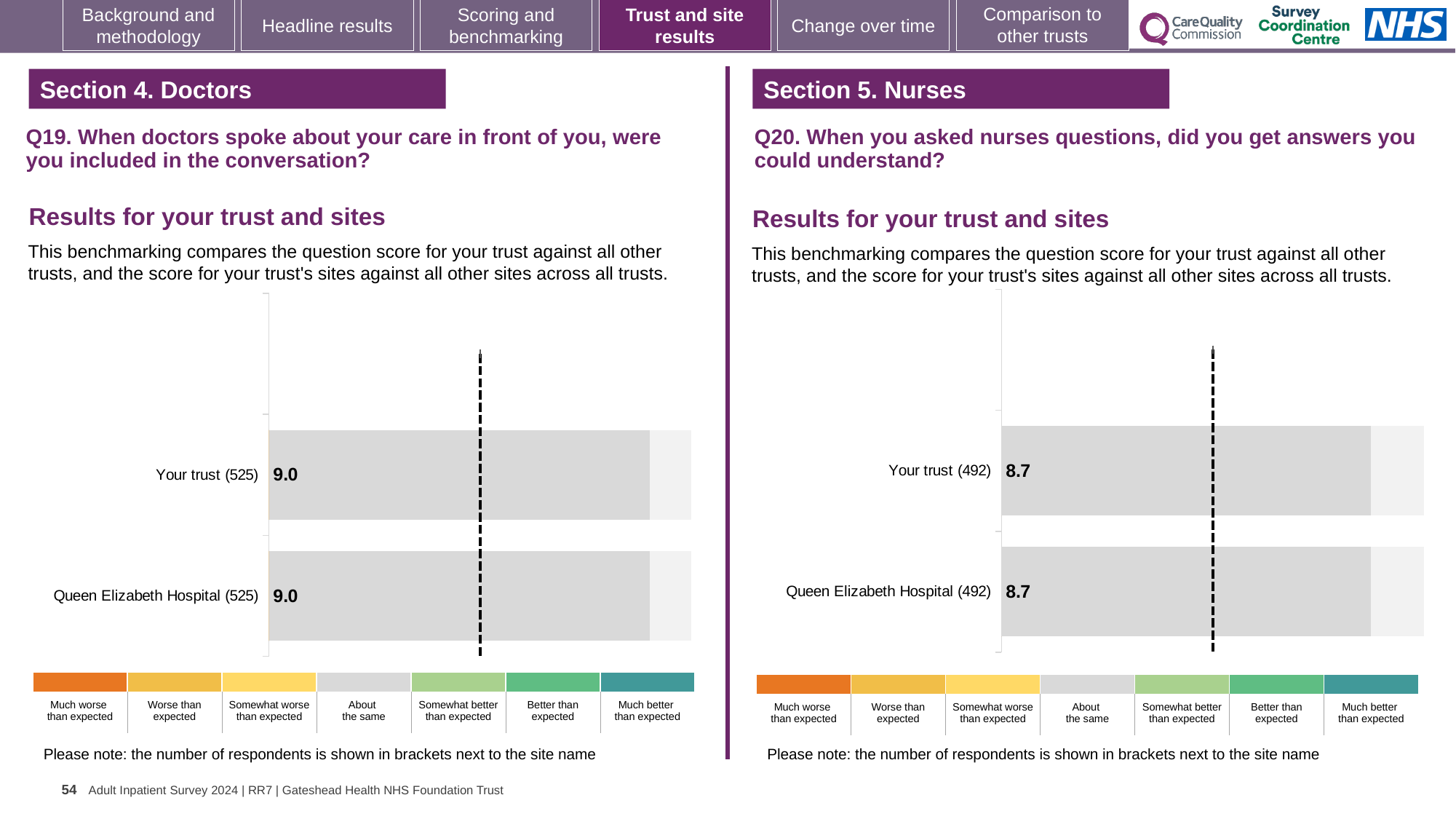
Which is larger: the Your trust score in the Q19 chart on the left or the Your trust score in the Q20 chart on the right? Q19 chart on the left In the Q19 chart on the left, how many respondents are shown in brackets next to Your trust? 525 In the Q19 chart on the left, what is the score for Your trust? 9.0 In the Q20 chart on the right, how many respondents are shown in brackets next to Queen Elizabeth Hospital? 492 In the Q19 chart on the left, what is the score for Queen Elizabeth Hospital? 9.0 What is the difference between the Your trust score in the Q19 chart on the left and the Your trust score in the Q20 chart on the right? 0.3 In the Q20 chart on the right, what is the score for Queen Elizabeth Hospital? 8.7 How many bars are plotted in the Q20 chart on the right? 2 In the Q19 chart on the left, how many categories does the colour key below the chart list? 7 What kind of chart is used in the Q20 chart on the right? Bar chart How many bars are plotted in the Q19 chart on the left? 2 In the Q20 chart on the right, what is the score for Your trust? 8.7